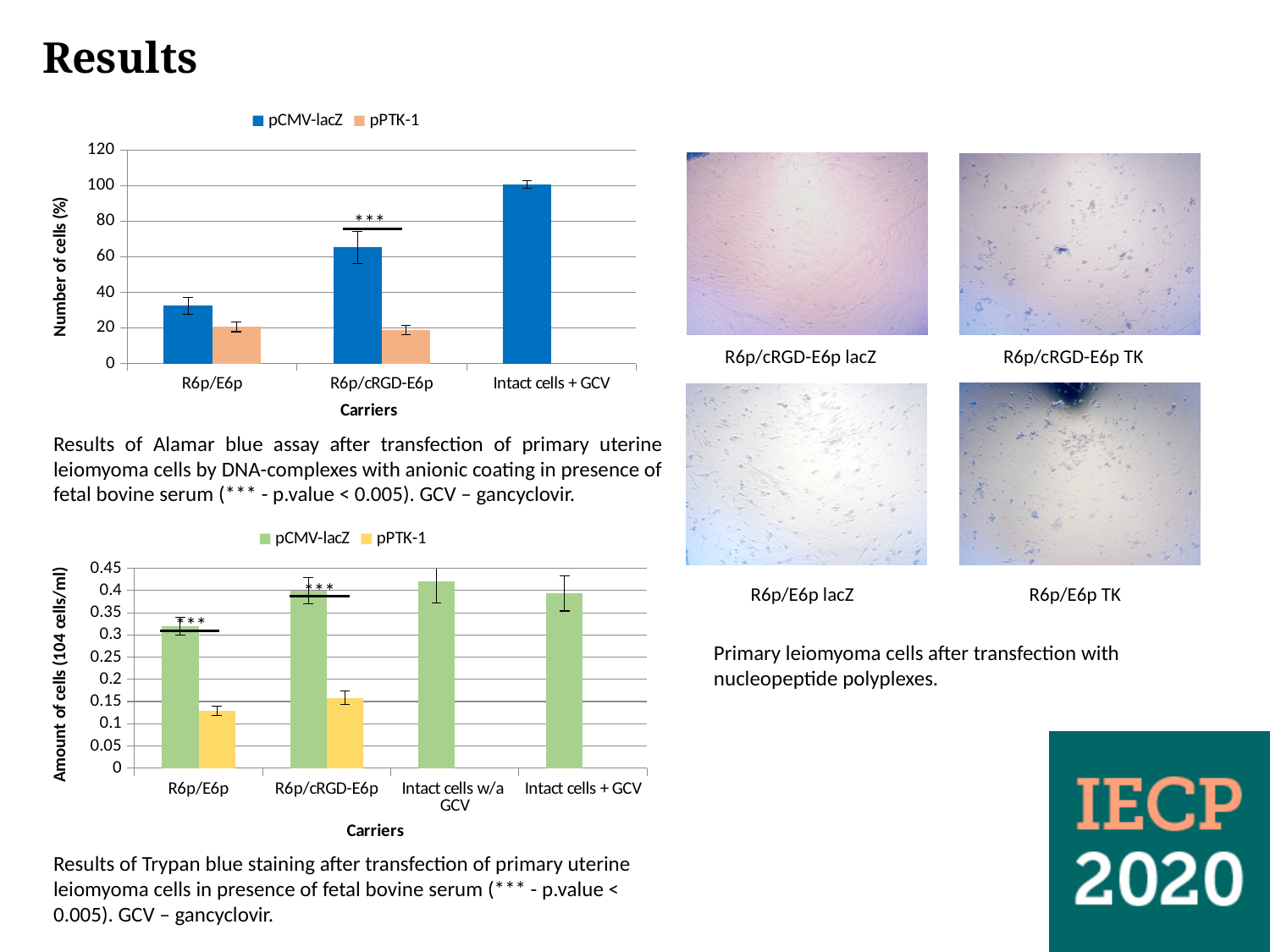
How many categories are shown on the x axis of the top chart (Number of cells (%))? 3 How many categories are shown on the x axis of the bottom chart (Amount of cells)? 4 In the top chart (Number of cells (%)), is the pPTK-1 value for R6p/E6p greater or less than 40? less How many series does the legend of the top chart (Number of cells (%)) list? 2 In the top chart (Number of cells (%)), which category has the highest pCMV-lacZ bar? Intact cells + GCV What kind of chart is the top chart on the slide (y axis 'Number of cells (%)')? bar chart In the bottom chart (Amount of cells), is the pCMV-lacZ value for Intact cells w/a GCV greater or less than 0.3? greater In the top chart (Number of cells (%)), is the pCMV-lacZ value for R6p/cRGD-E6p greater or less than 40? greater In the bottom chart (Amount of cells), which category has the lowest pPTK-1 bar? R6p/E6p In the top chart (Number of cells (%)), for R6p/cRGD-E6p, which series has the larger value, pCMV-lacZ or pPTK-1? pCMV-lacZ What is the x-axis title of the bottom chart (Amount of cells)? Carriers